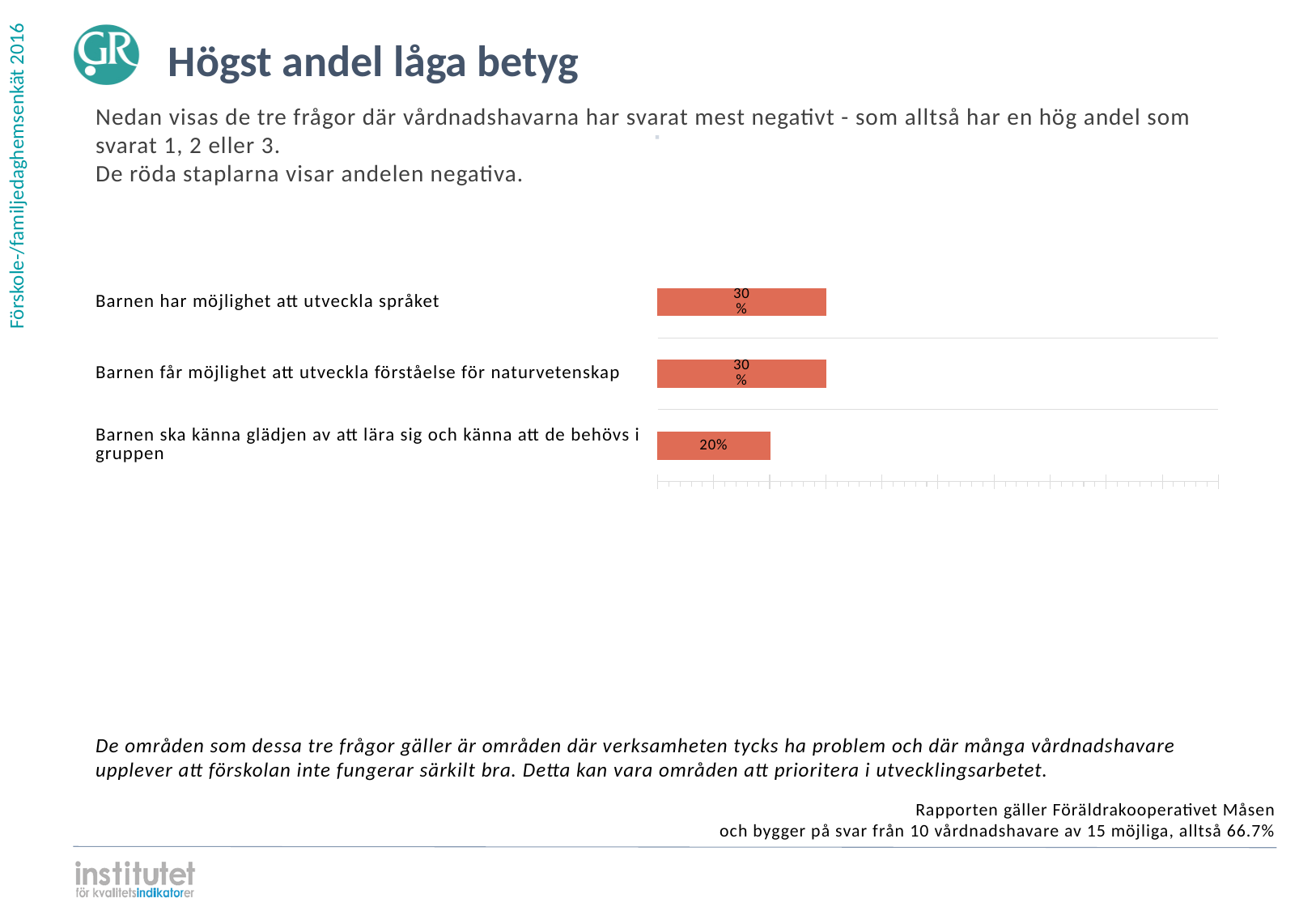
What kind of chart is shown on the slide? Bar chart What colour are the bars in the chart? Red Which is larger: the value for "Barnen har möjlighet att utveckla språket" or the value for "Barnen ska känna glädjen av att lära sig och känna att de behövs i gruppen"? Barnen har möjlighet att utveckla språket How many categories are shown in the chart? 3 How many categories have a value of 30%? 2 What is the value for "Barnen ska känna glädjen av att lära sig och känna att de behövs i gruppen"? 20% What is the value for "Barnen får möjlighet att utveckla förståelse för naturvetenskap"? 30% What is the difference between the value for "Barnen får möjlighet att utveckla förståelse för naturvetenskap" and the value for "Barnen ska känna glädjen av att lära sig och känna att de behövs i gruppen"? 10 percentage points What is the title of the slide containing the chart? Högst andel låga betyg What is the value for "Barnen har möjlighet att utveckla språket"? 30% Which category has the lowest value? Barnen ska känna glädjen av att lära sig och känna att de behövs i gruppen